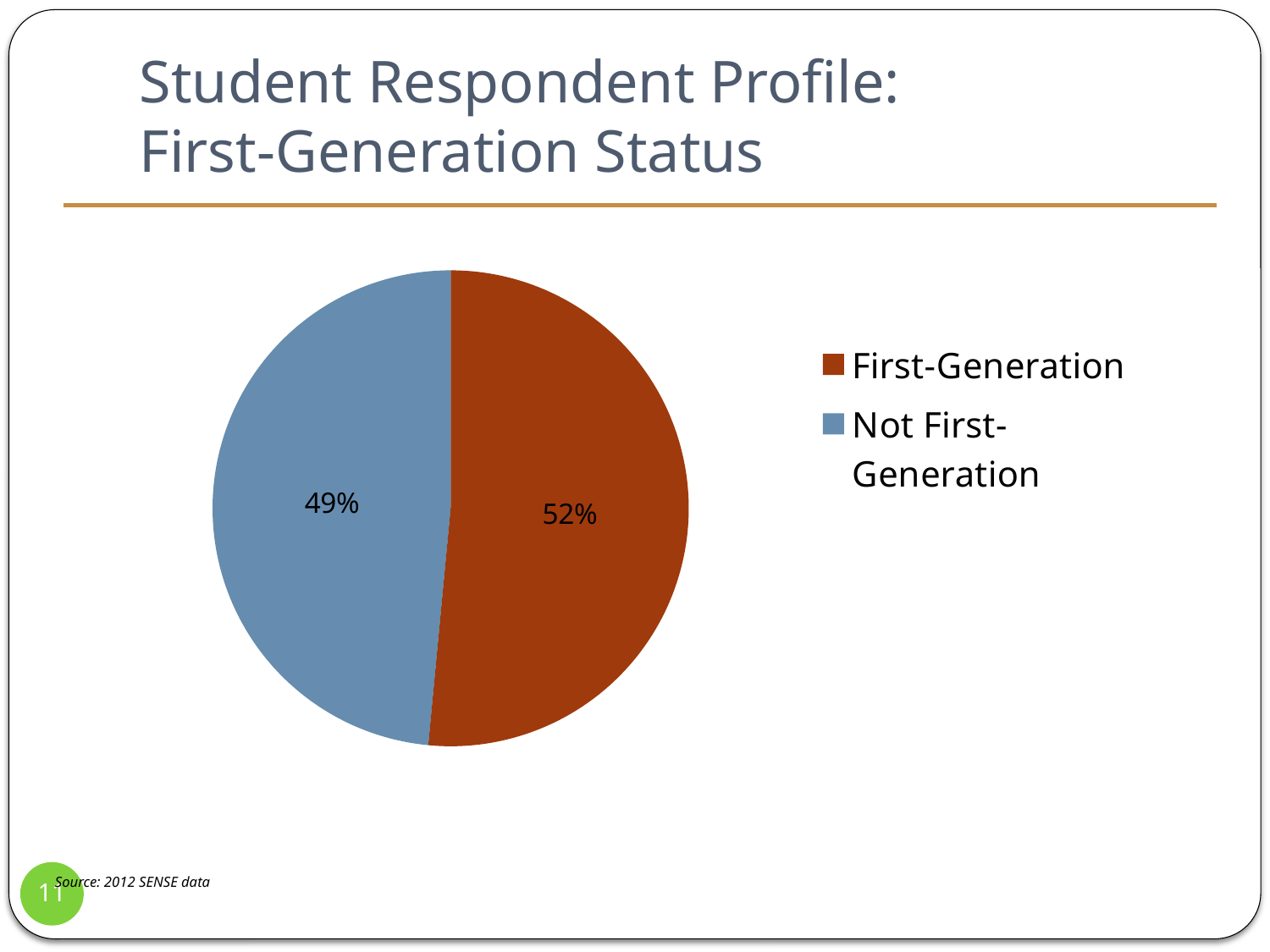
What colour is the First-Generation slice? dark orange (rust) What percentage of respondents are First-Generation? 52% What share of the pie does the Not First-Generation slice represent? 49% How many slices does the pie chart have? 2 What is the difference in percentage points between the First-Generation and Not First-Generation slices? 3 What is the title of the slide containing the chart? Student Respondent Profile: First-Generation Status What kind of chart is shown on the slide? pie chart Which category has the smaller share of the pie? Not First-Generation Which category has the larger share of the pie? First-Generation What percentage of respondents are Not First-Generation? 49% Is the share for First-Generation larger or smaller than the share for Not First-Generation? larger How many entries does the legend list? 2